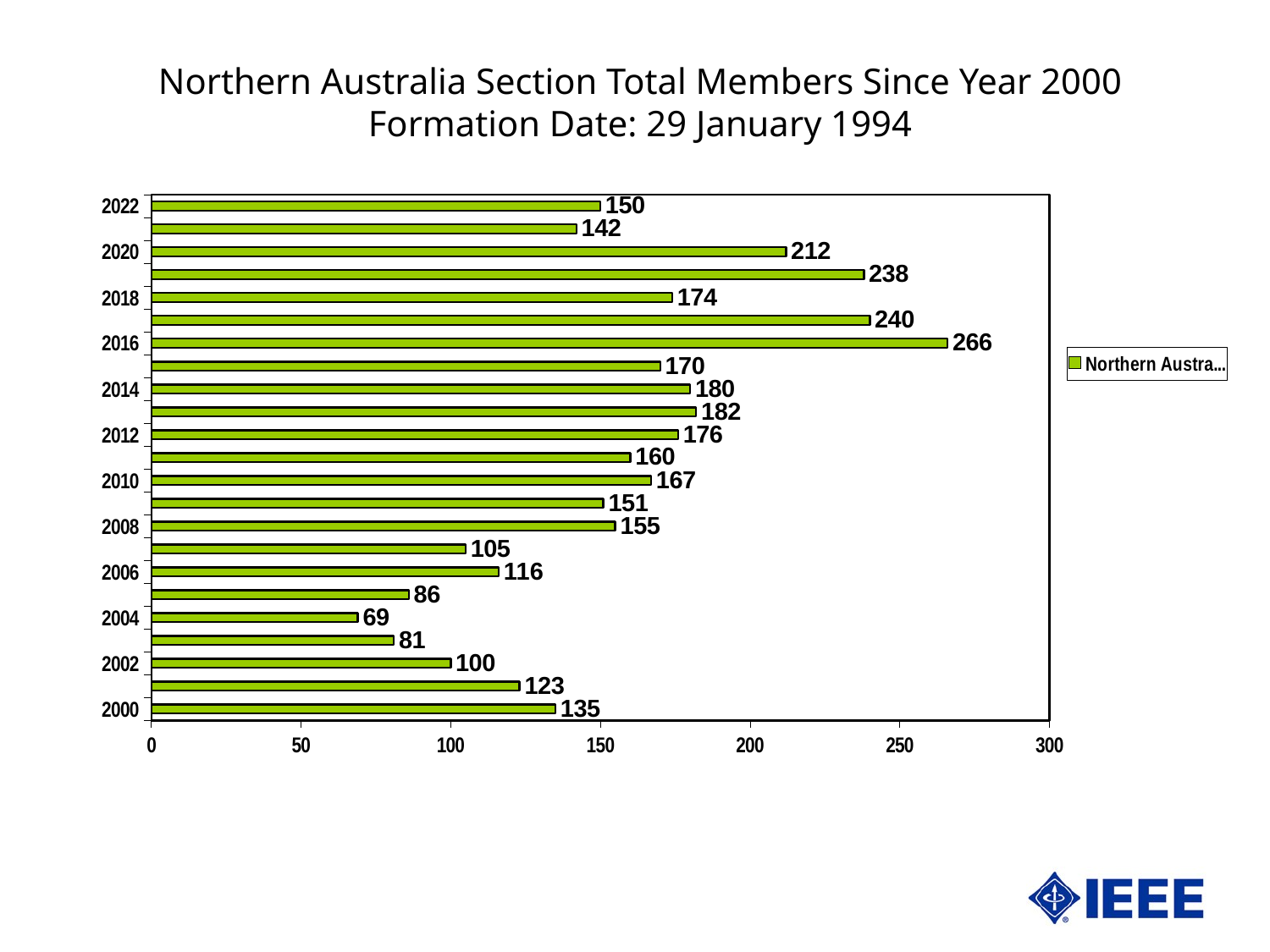
What is the value for 2016? 266 Which is larger, the value for 2020 or the value for 2022? 2020 What type of chart is shown on the slide? bar chart Is the value for 2010 greater or less than 150? greater What is the value for 2000? 135 Which year has the highest value? 2016 What is the value for 2022? 150 What is the difference between the values for 2016 and 2018? 92 Which year has the lowest value? 2004 What is the value for 2004? 69 How many series does the legend list? 1 How many bars are plotted in the chart? 23